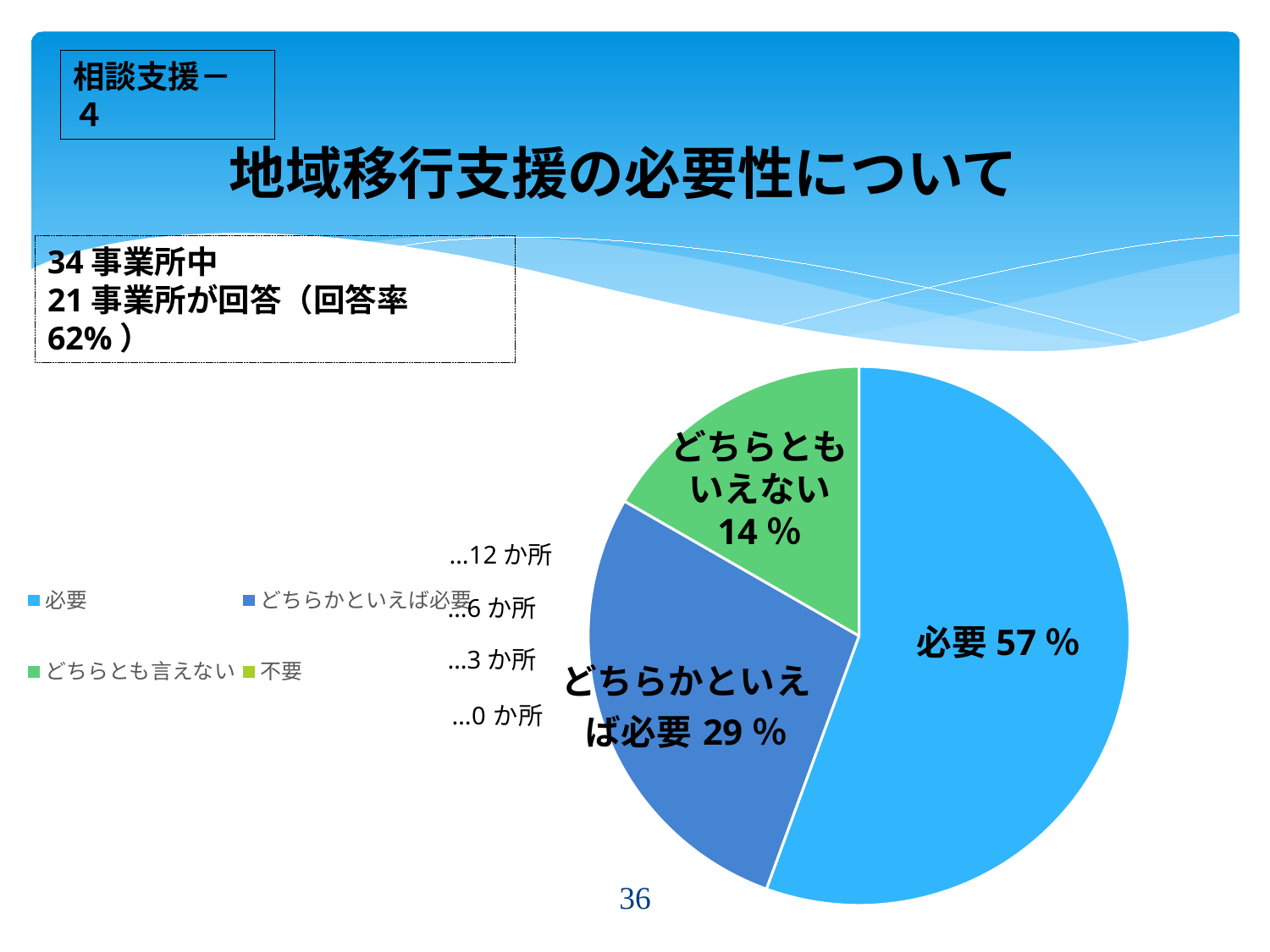
What percentage of the pie is the どちらかといえば必要 slice? 29 % Which slice of the pie is the largest? 必要 How many percentage points larger is the どちらかといえば必要 slice than the どちらともいえない slice? 15 How many entries does the legend list? 4 What is the title of the slide containing the pie chart? 地域移行支援の必要性について What kind of chart is shown on the slide? pie chart What percentage of the pie is the 必要 slice? 57 % What percentage of the pie is the どちらともいえない slice? 14 % Of the three labelled slices, which is the smallest? どちらともいえない How many percentage points larger is the 必要 slice than the どちらかといえば必要 slice? 28 Is the 必要 slice greater or less than 50% of the pie? greater Which is larger, the 必要 slice or the どちらかといえば必要 slice? 必要